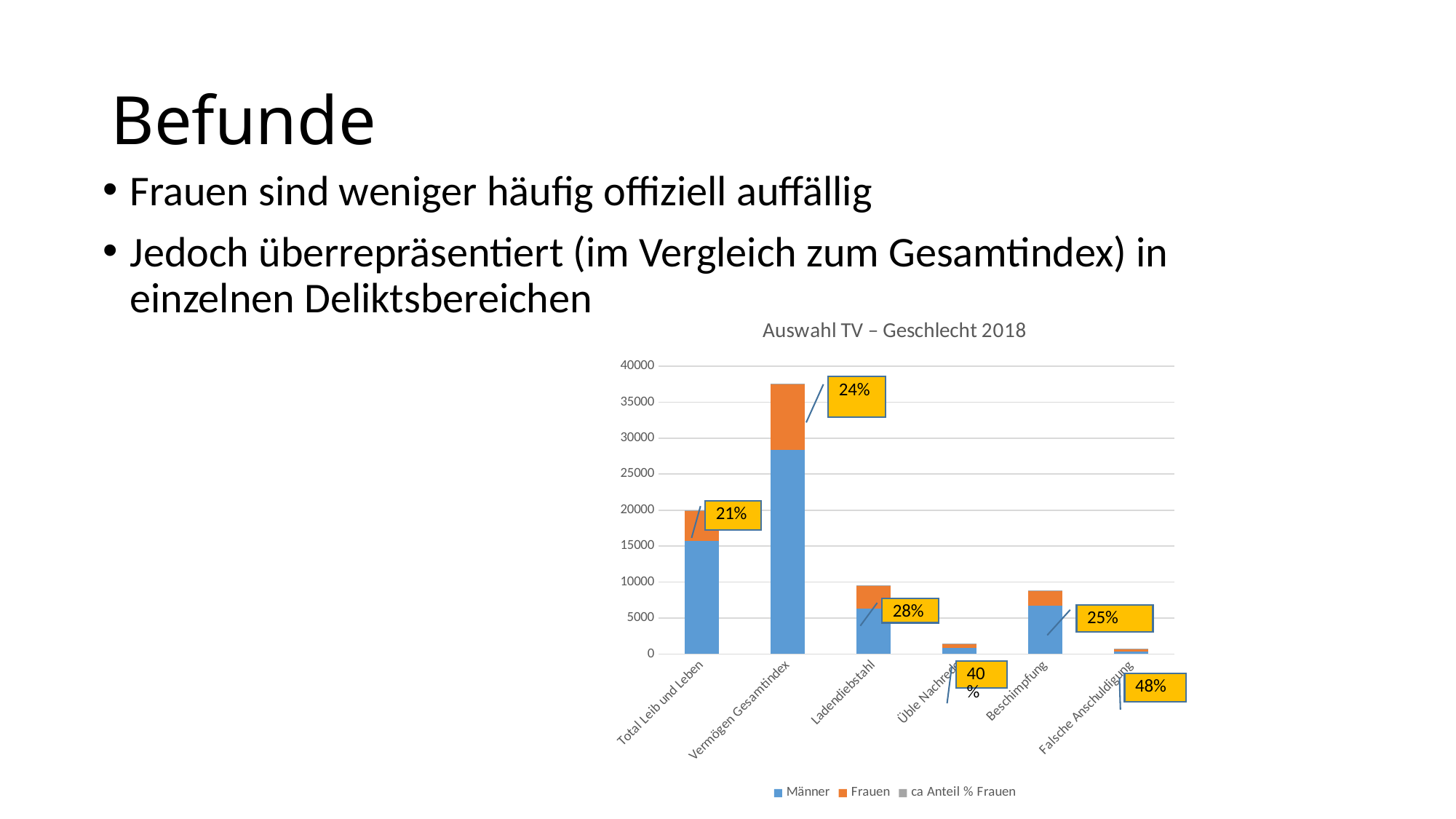
Which category has the shortest stacked bar in the chart? Falsche Anschuldigung What is the title of the chart? Auswahl TV – Geschlecht 2018 How many series does the chart legend list? 3 How many categories are shown on the x axis of the chart? 6 What percentage is shown in the callout label for Falsche Anschuldigung? 48% Which category has the tallest stacked bar in the chart? Vermögen Gesamtindex What type of chart is shown on the slide? Stacked bar chart What percentage is shown in the callout label for Ladendiebstahl? 28% Which category has the highest percentage shown in its callout label? Falsche Anschuldigung Is the total stacked value for Ladendiebstahl greater or less than 10000? less What percentage is shown in the callout label for Total Leib und Leben? 21% Is the total stacked value for Vermögen Gesamtindex greater or less than 35000? greater